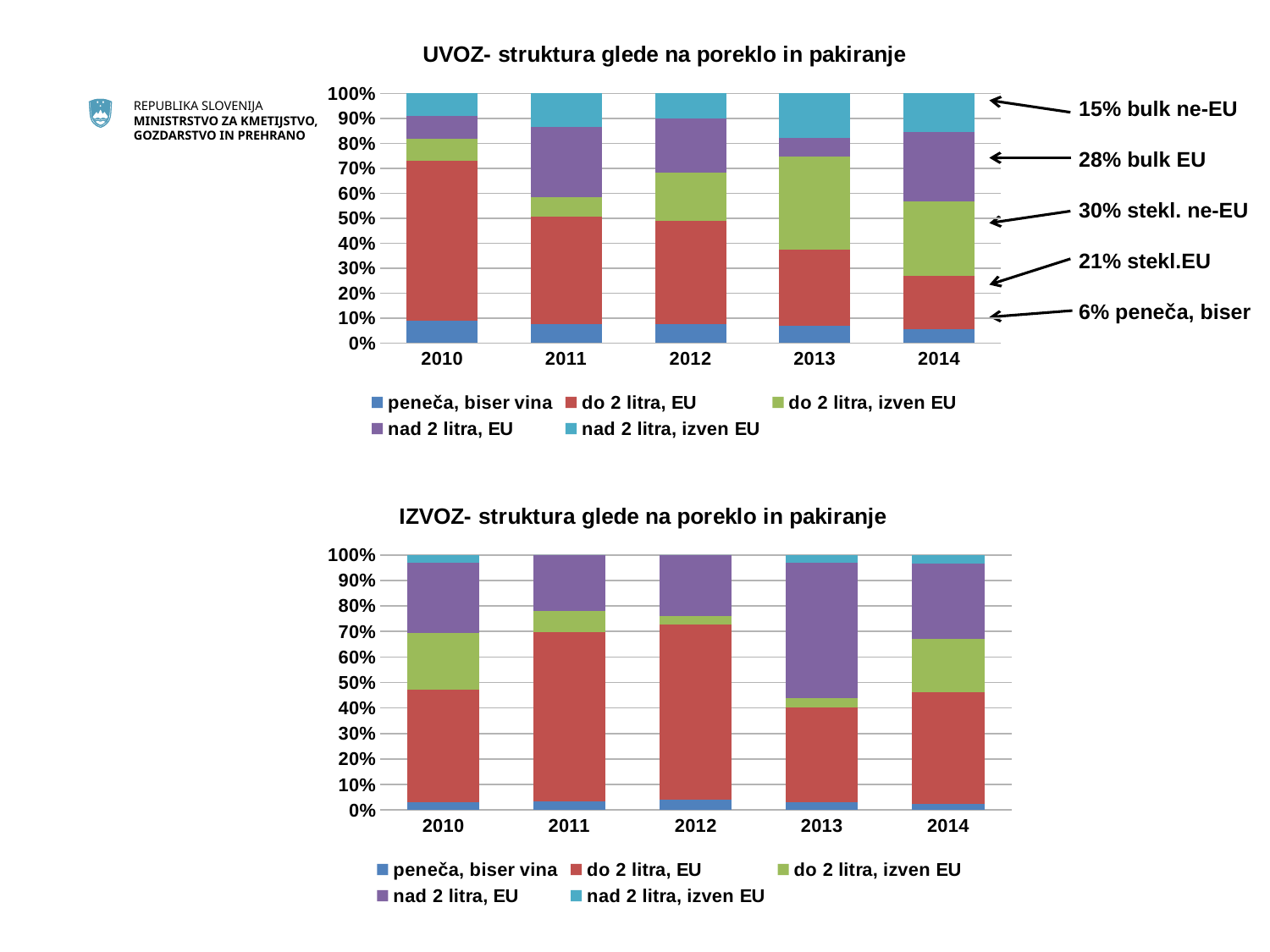
How many series does the legend of the UVOZ chart list? 5 What kind of chart is the UVOZ chart at the top of the slide? stacked bar chart What is the title of the bottom chart? IZVOZ- struktura glede na poreklo in pakiranje In the UVOZ chart, what share is labelled for stekl. ne-EU in 2014? 30% In the UVOZ chart, what is the difference between the 2014 shares labelled for stekl. ne-EU (30%) and stekl.EU (21%)? 9% In the UVOZ chart, what share is labelled for bulk ne-EU in 2014? 15% In the IZVOZ chart, which year has the largest 'nad 2 litra, EU' segment? 2013 How many years are shown on the x axis of the IZVOZ chart? 5 In the IZVOZ chart, is the 'nad 2 litra, EU' segment larger in 2013 or in 2012? 2013 In the UVOZ chart, is the cumulative share up to and including 'do 2 litra, EU' in 2010 greater or less than 70%? greater In the UVOZ chart, does the share of 'do 2 litra, EU' rise or fall from 2010 to 2014? fall In the UVOZ chart, what share is labelled for peneča, biser in 2014? 6%